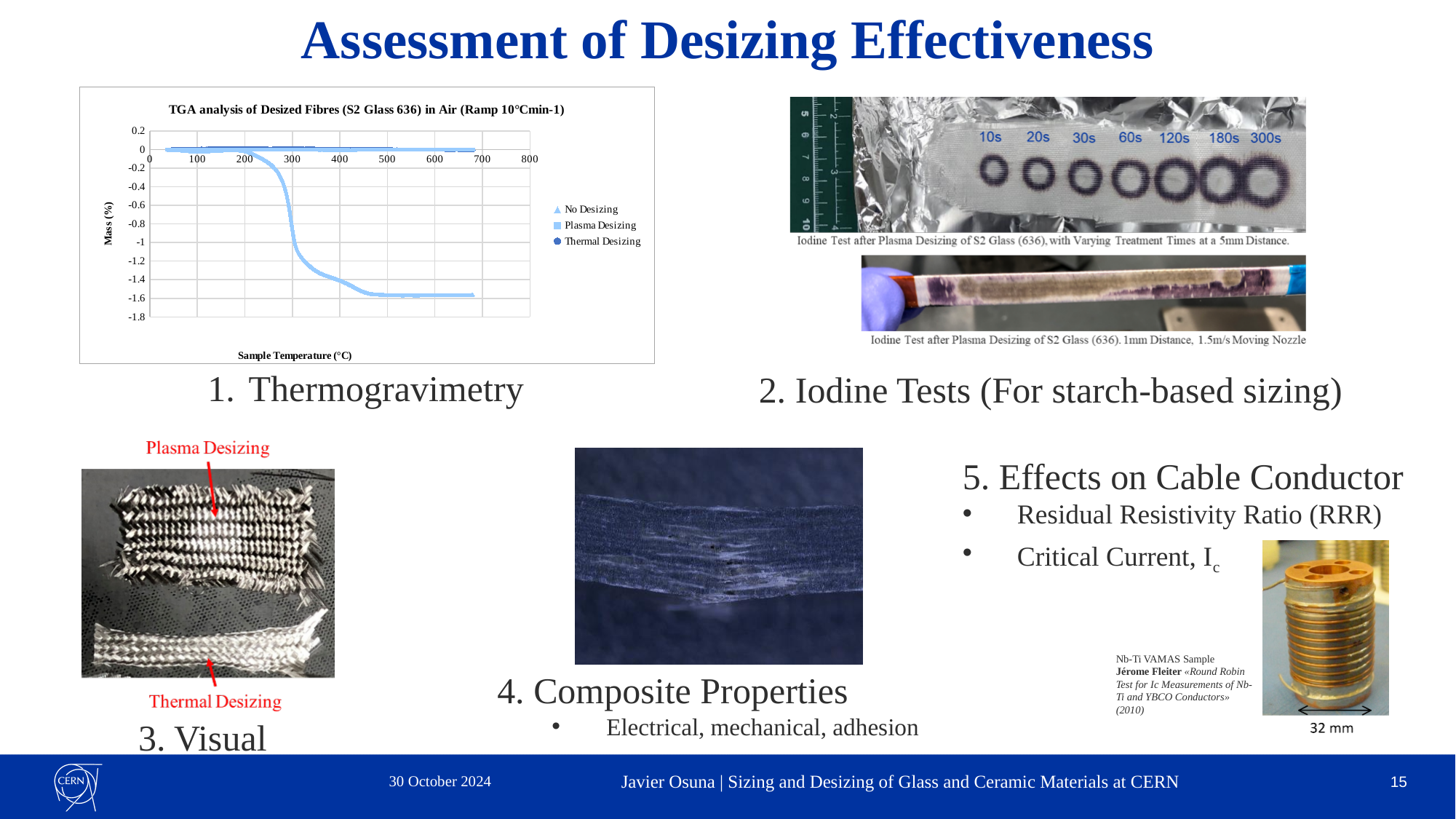
In the TGA analysis chart, is the value of the lowest series at 600 °C greater or less than -1.8? greater In the TGA analysis chart, is the value of the lowest series at 600 °C greater or less than -1.4? less What is the highest tick value shown on the x axis of the TGA analysis chart? 800 How many series does the legend of the TGA analysis chart list? 3 In the TGA analysis chart, is the value of the lowest series at 100 °C greater or less than -0.2? greater What is the label of the y axis of the TGA analysis chart? Mass (%) What kind of chart is the TGA analysis chart on the slide? line chart What is the title of the chart on the slide? TGA analysis of Desized Fibres (S2 Glass 636) in Air (Ramp 10°Cmin-1) In the TGA analysis chart, does the series that drops sharply rise or fall as the sample temperature increases from 200 to 500 °C? fall